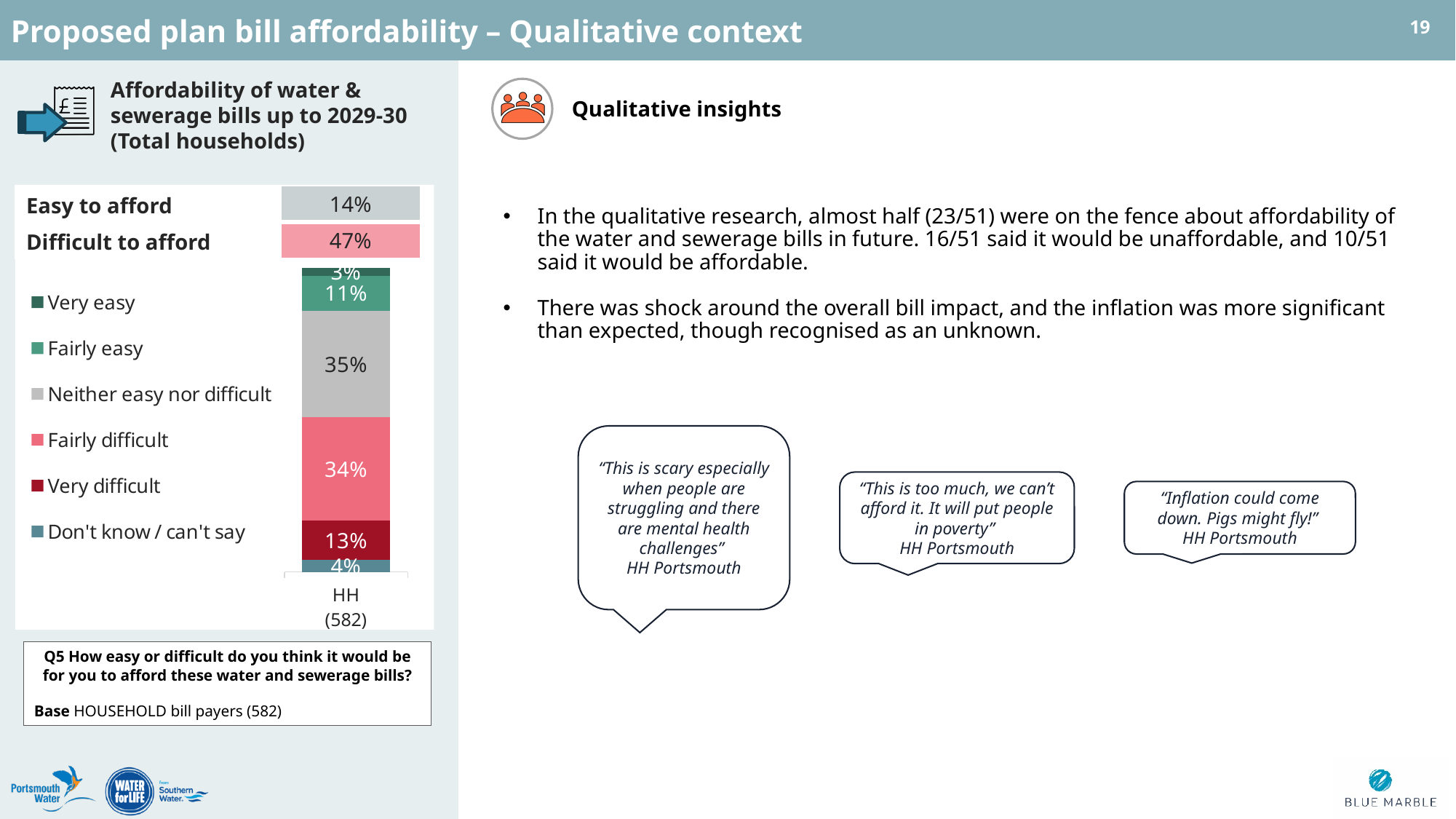
What is the 'Difficult to afford' summary percentage shown above the chart? 47% What percentage of households said 'Very difficult'? 13% What type of chart is used to show the affordability responses? Stacked bar chart Which response category has the smallest share in the stacked bar? Very easy What percentage of households said 'Fairly easy'? 11% Which is larger: the share for 'Fairly difficult' or the share for 'Very difficult'? Fairly difficult What percentage of households said it would be 'Fairly difficult' to afford the bills? 34% How many response categories does the chart legend list? 6 What percentage of households answered 'Neither easy nor difficult'? 35% Which response category has the largest share in the stacked bar? Neither easy nor difficult What is the difference between the 'Difficult to afford' and 'Easy to afford' summary percentages? 33 percentage points What is the 'Easy to afford' summary percentage shown above the chart? 14%